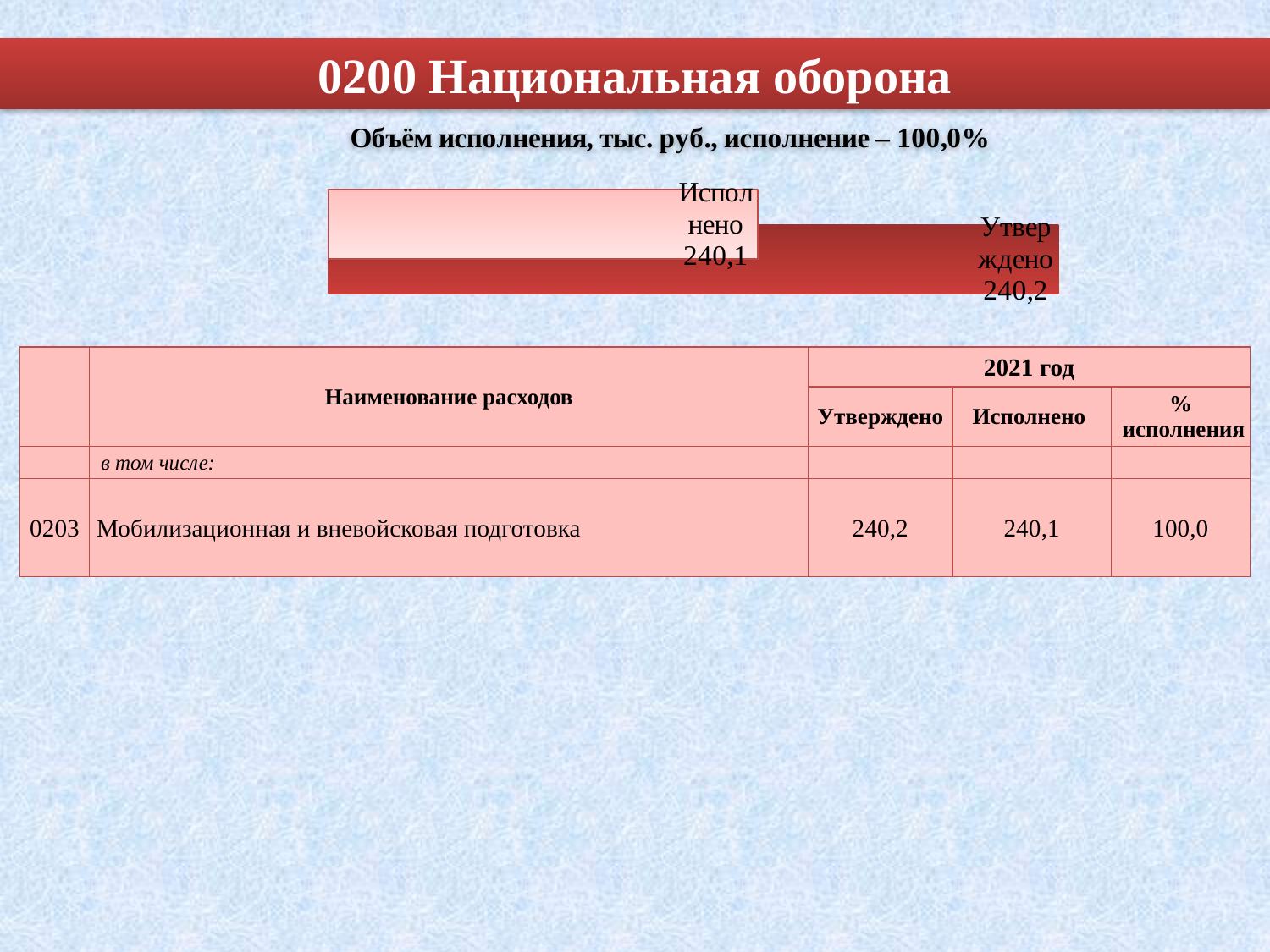
What type of chart is shown on the slide? bar chart Which category has the highest value in the chart? Утверждено How many bars are plotted in the chart? 2 What colour is the Утверждено bar in the chart? dark red What is the title shown above the chart? Объём исполнения, тыс. руб., исполнение – 100,0% What is the value for Исполнено in the chart? 240,1 What is the difference between the Утверждено and Исполнено values in the chart? 0,1 What is the value for Утверждено in the chart? 240,2 Which bar has the higher value, Утверждено or Исполнено? Утверждено Which category has the lowest value in the chart? Исполнено